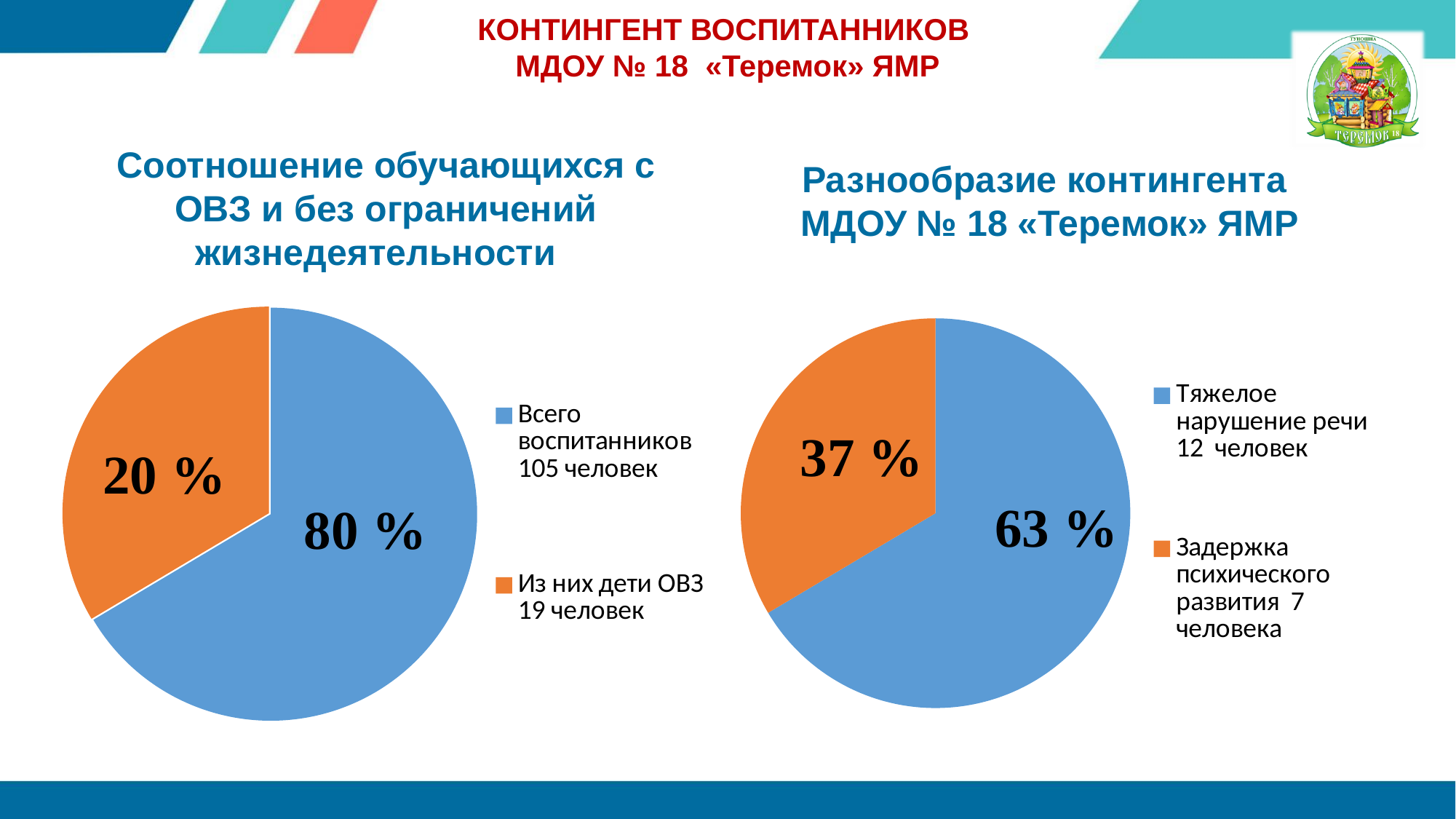
In the right pie chart, what colour is the slice for 'Тяжелое нарушение речи 12 человек'? Blue In the left pie chart (Соотношение обучающихся с ОВЗ и без ограничений жизнедеятельности), what share is labelled for the blue slice 'Всего воспитанников 105 человек'? 80 % How many entries does the legend of the right pie chart list? 2 In the right pie chart, what is the difference in percentage points between the 63 % slice and the 37 % slice? 26 In the right pie chart, what share is labelled for 'Задержка психического развития 7 человека'? 37 % In the left pie chart, what is the difference in percentage points between the 80 % slice and the 20 % slice? 60 In the left pie chart, what share is labelled for the orange slice 'Из них дети ОВЗ 19 человек'? 20 % In the right pie chart, which slice is the smallest? Задержка психического развития 7 человека What type of chart is shown on the left side of the slide? Pie chart In the left pie chart, which slice is the largest? Всего воспитанников 105 человек How many slices does the left pie chart have? 2